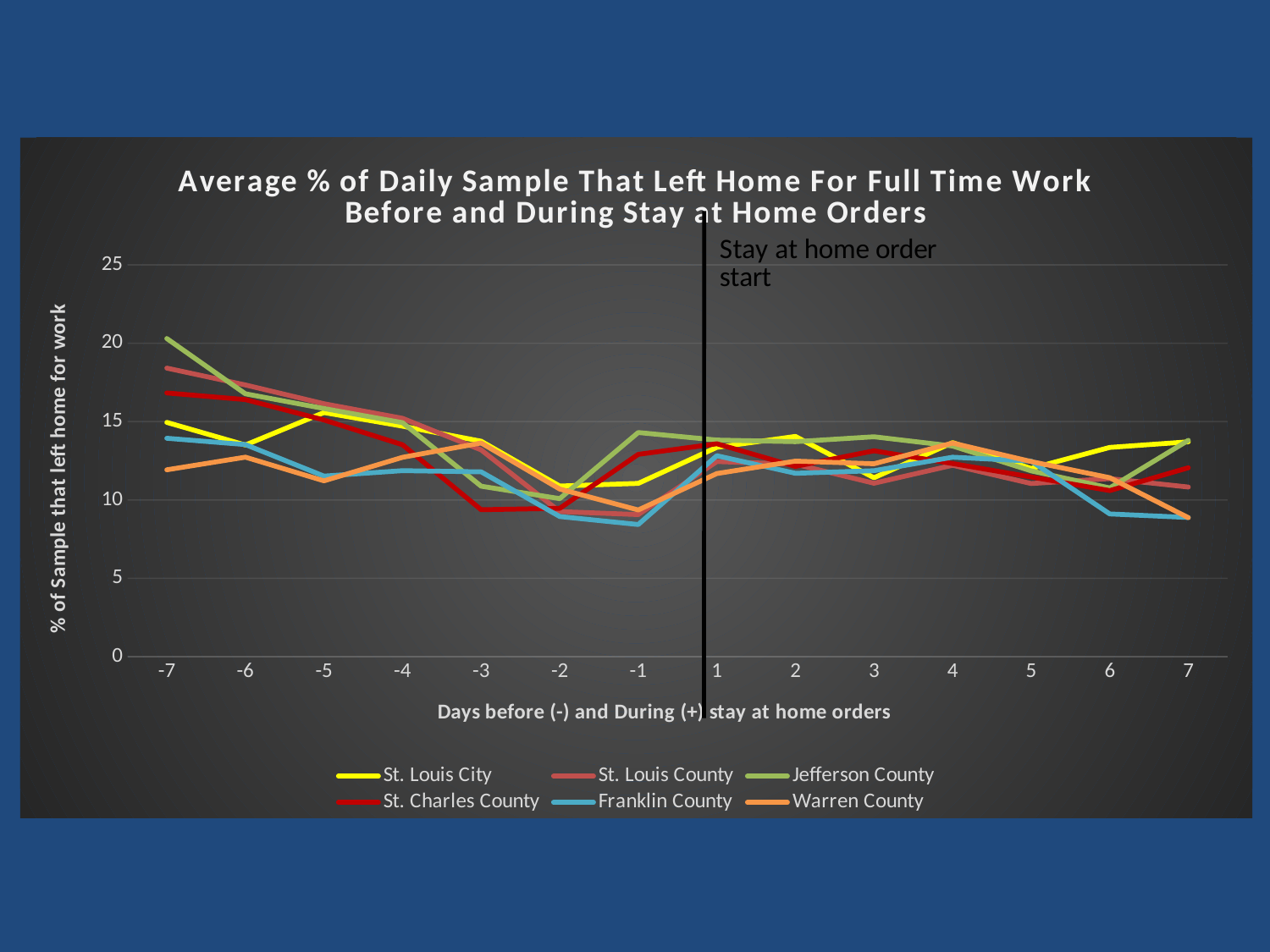
Which county has the highest value at day -7? Jefferson County How many day values are shown along the x axis? 14 Does the Jefferson County line rise or fall from day -7 to day -2? fall What is the title of the chart? Average % of Daily Sample That Left Home For Full Time Work Before and During Stay at Home Orders What kind of chart is shown on the slide? line chart Is the value for Franklin County at day 7 greater or less than 10? less Which county has the lowest value at day -7? Warren County Is the value for St. Charles County at day -3 greater or less than 10? less Is the value for Jefferson County at day -7 greater or less than 15? greater At day -7, which is larger: St. Louis County or Franklin County? St. Louis County How many series does the legend list? 6 What does the vertical black line on the chart mark? Stay at home order start